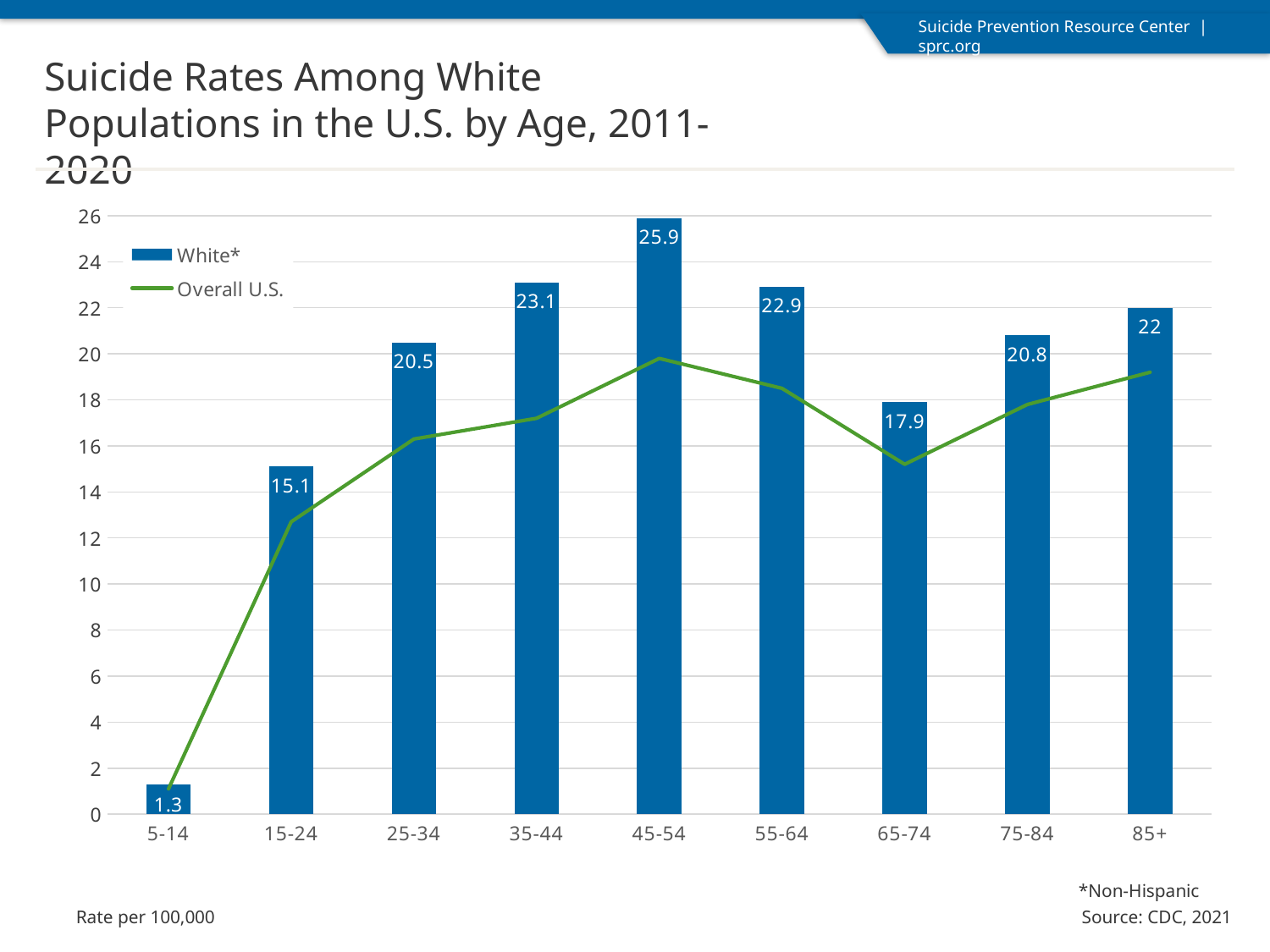
What is the suicide rate for the White* population in the 45-54 age group? 25.9 Is the Overall U.S. value for the 65-74 age group greater or less than 16? less What kind of chart is used to show the White* series? bar chart What is the suicide rate for the White* population in the 85+ age group? 22 How many age groups are shown on the x axis? 9 How many series does the legend list? 2 Which age group has the lowest suicide rate for the White* population? 5-14 Which age group has the highest suicide rate for the White* population? 45-54 What is the difference between the White* suicide rates for the 45-54 and 65-74 age groups? 8 What is the suicide rate for the White* population in the 5-14 age group? 1.3 What unit is the rate expressed in, according to the note at the bottom of the slide? Rate per 100,000 Which has a higher White* suicide rate, the 35-44 age group or the 55-64 age group? 35-44